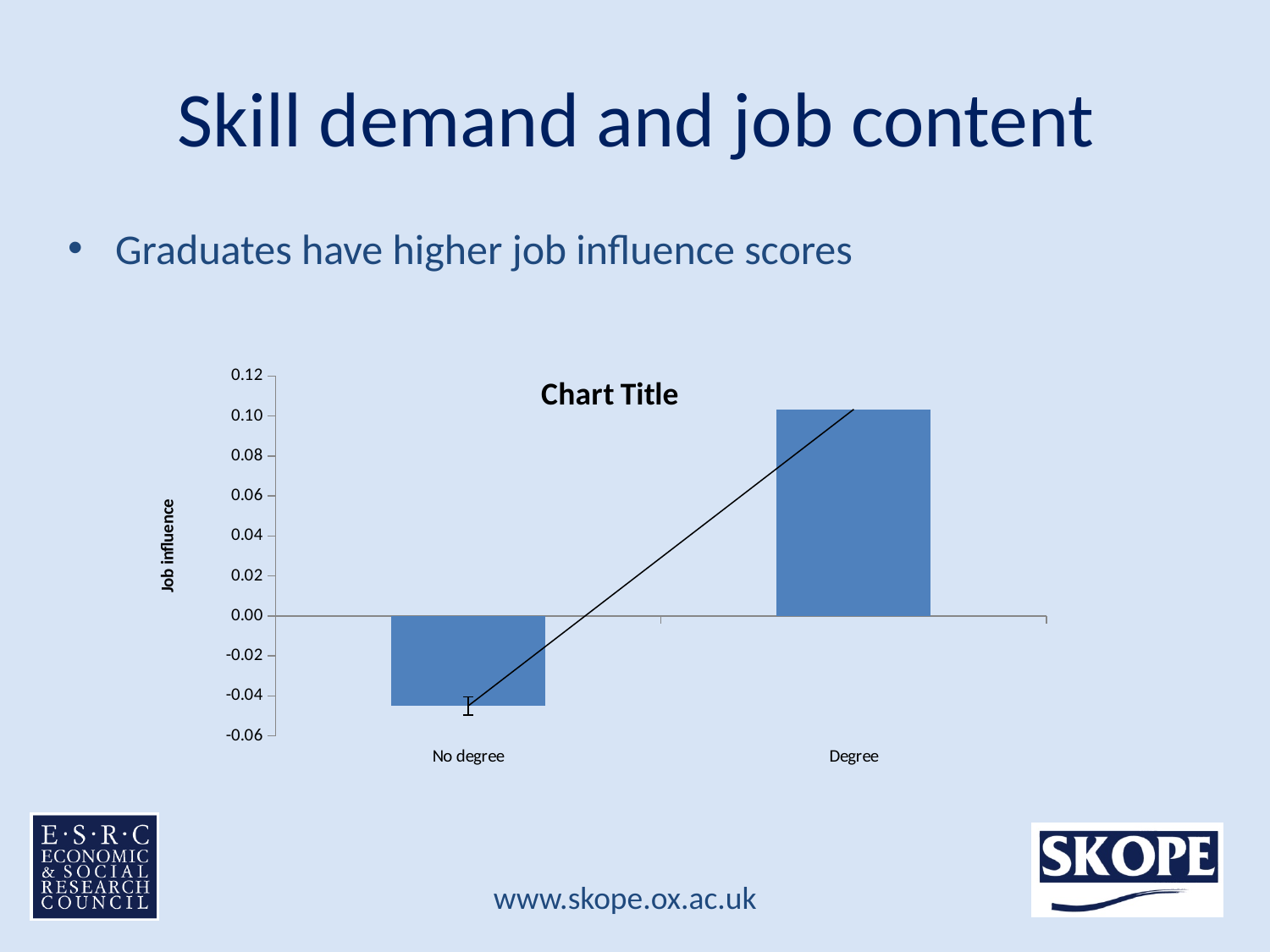
Is the value for Degree greater or less than 0.08? greater What title is displayed on the chart itself? Chart Title Which category has the highest job influence value? Degree Is the value for No degree greater or less than 0.00? less Which is larger, the value for Degree or the value for No degree? Degree What kind of chart is shown on the slide? bar chart Is the value for No degree greater or less than -0.02? less What is the label on the vertical axis of the chart? Job influence Which category has the lowest job influence value? No degree Do the values rise or fall moving from No degree to Degree along the x axis? rise How many categories are shown on the x axis of the chart? 2